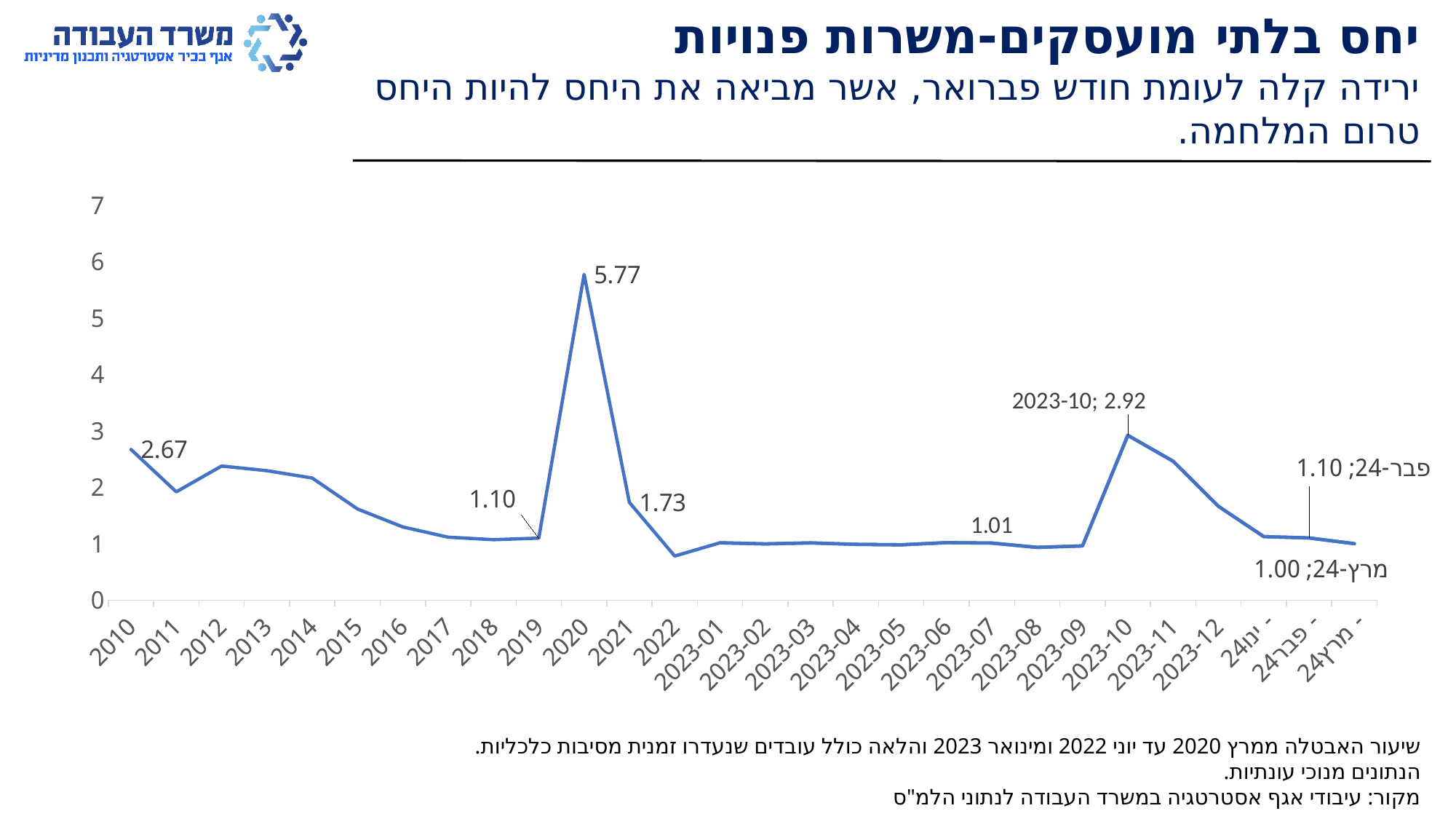
Is the value for 2014 greater or less than 2? greater What value is labelled for 2023-10? 2.92 What value is shown for 2020? 5.77 Which point on the x axis has the highest value? 2020 What value is labelled for פבר-24 (February 2024)? 1.10 What value is shown for 2010? 2.67 Which is larger, the value for 2010 or the value for 2021? 2010 What kind of chart is shown on the slide? line chart What is the difference between the 2020 value and the 2021 value? 4.04 Is the value for 2022 greater or less than 1? less What value is labelled for מרץ-24 (March 2024)? 1.00 What is the difference between the 2023-10 value and the פבר-24 value? 1.82